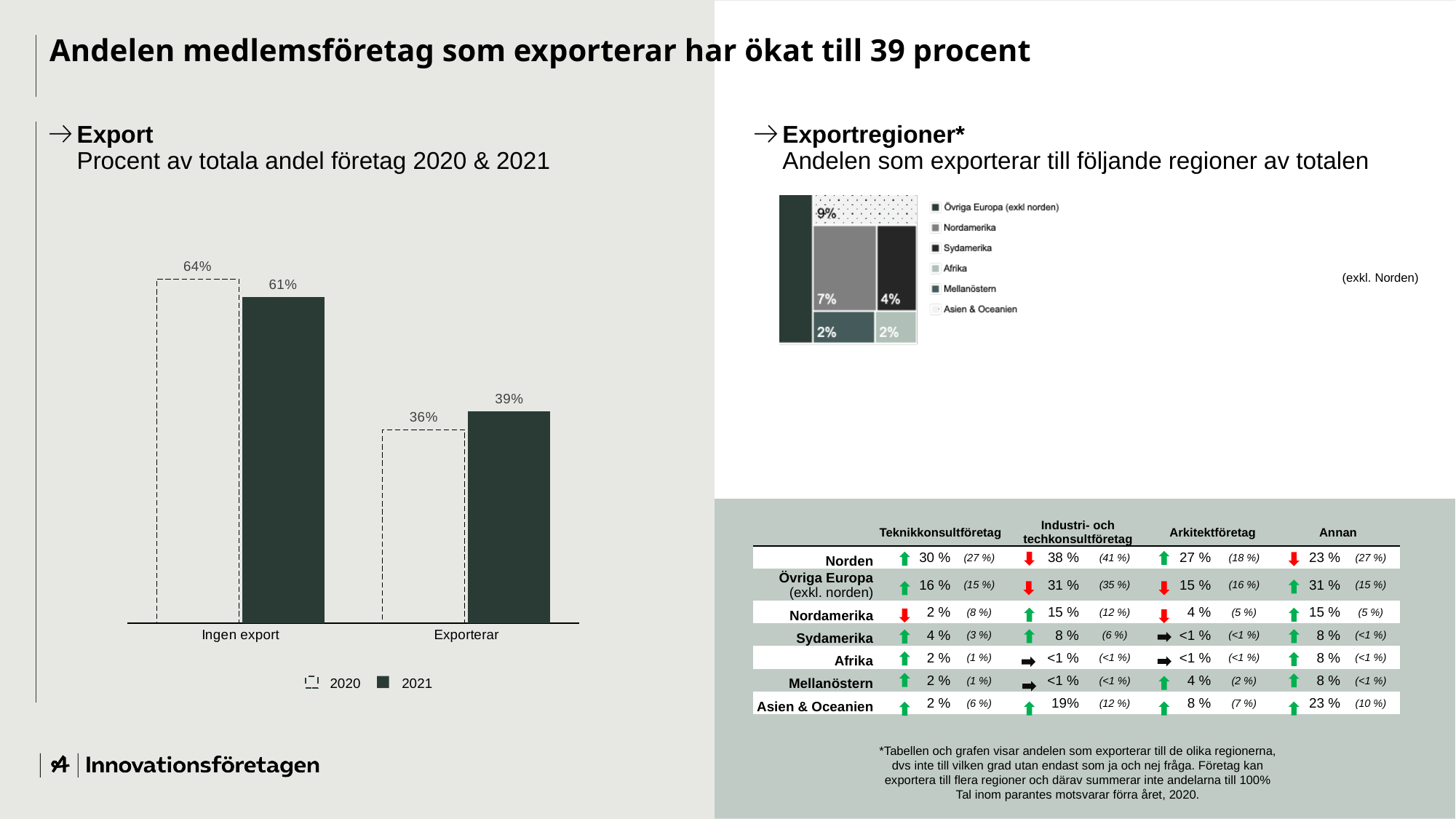
In the Export chart, what is the 2020 value for Ingen export? 64% In the Export chart, what is the difference between the 2021 values for Ingen export and Exporterar? 22 percentage points In the Export chart, which is larger for 2021: Ingen export or Exporterar? Ingen export In the Export chart, how many categories are shown on the x axis? 2 In the Exportregioner chart, what is the largest percentage printed on the treemap? 9% In the Exportregioner chart, how many regions does the legend list? 6 In the Export chart, what is the 2021 value for Ingen export? 61% In the Export chart, by how many percentage points did Exporterar change from 2020 to 2021? 3 percentage points What type of chart is the Export chart? Bar chart In the Export chart, how many series does the legend list? 2 In the Export chart, what is the 2020 value for Exporterar? 36% In the Export chart, what is the 2021 value for Exporterar? 39%